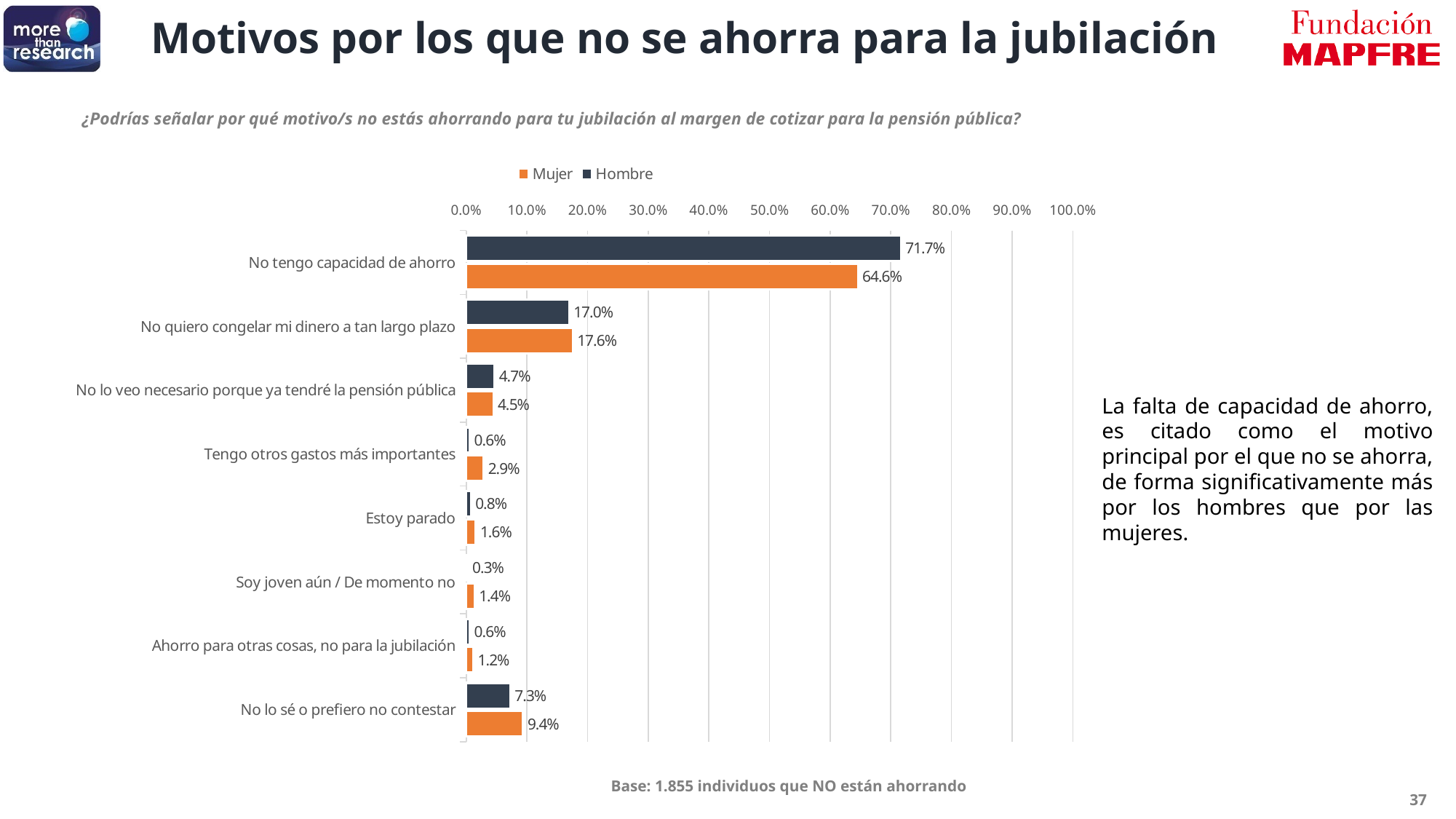
What is the Mujer value for "No lo sé o prefiero no contestar"? 9.4% What is the difference between the Hombre and Mujer values for "No tengo capacidad de ahorro"? 7.1% Is the Mujer value for "No tengo capacidad de ahorro" greater or less than 60.0%? greater Which category has the lowest Hombre value? Soy joven aún / De momento no For "Tengo otros gastos más importantes", which is larger, the Mujer value or the Hombre value? Mujer What is the Hombre value for "No tengo capacidad de ahorro"? 71.7% How many series does the legend list? 2 How many categories are shown on the chart? 8 What is the Mujer value for "No tengo capacidad de ahorro"? 64.6% What is the Hombre value for "Soy joven aún / De momento no"? 0.3% Which category has the highest Mujer value? No tengo capacidad de ahorro What kind of chart is shown on the slide? Bar chart